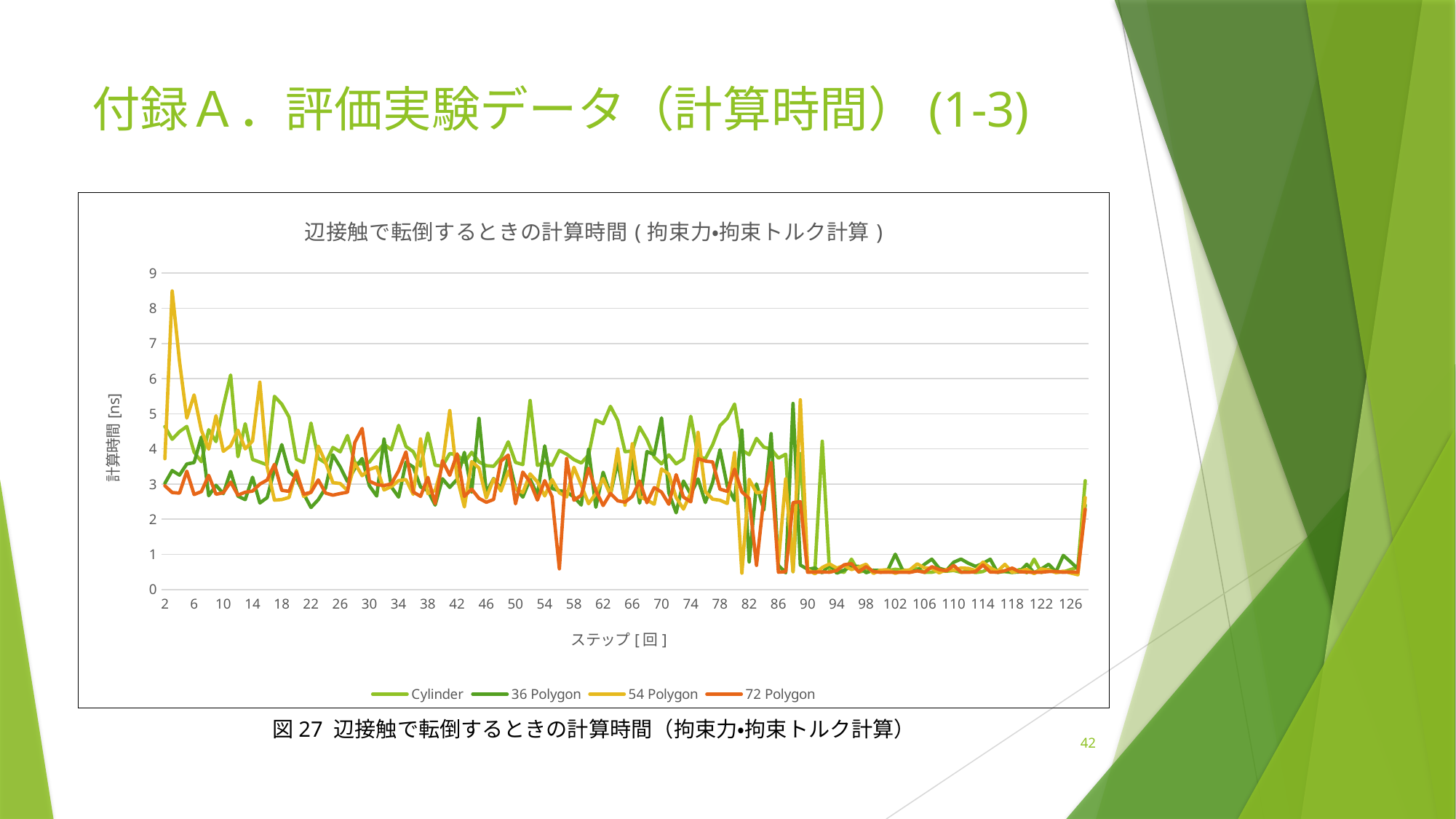
Is the highest peak of the 54 Polygon series greater or less than 8? greater What are the four series named in the legend? Cylinder, 36 Polygon, 54 Polygon, 72 Polygon What is the label of the vertical axis? 計算時間 [ns] What is the maximum value shown on the vertical axis? 9 What kind of chart is shown on the slide? line chart Which series reaches the highest peak value on the chart? 54 Polygon Is the value for the Cylinder series at step 2 greater or less than 4? greater Overall, do the computation time values rise or fall as the step number increases along the x axis? fall Is the value for the 36 Polygon series at step 110 greater or less than 2? less How many series does the legend list? 4 At step 2, which series has the larger value: Cylinder or 72 Polygon? Cylinder